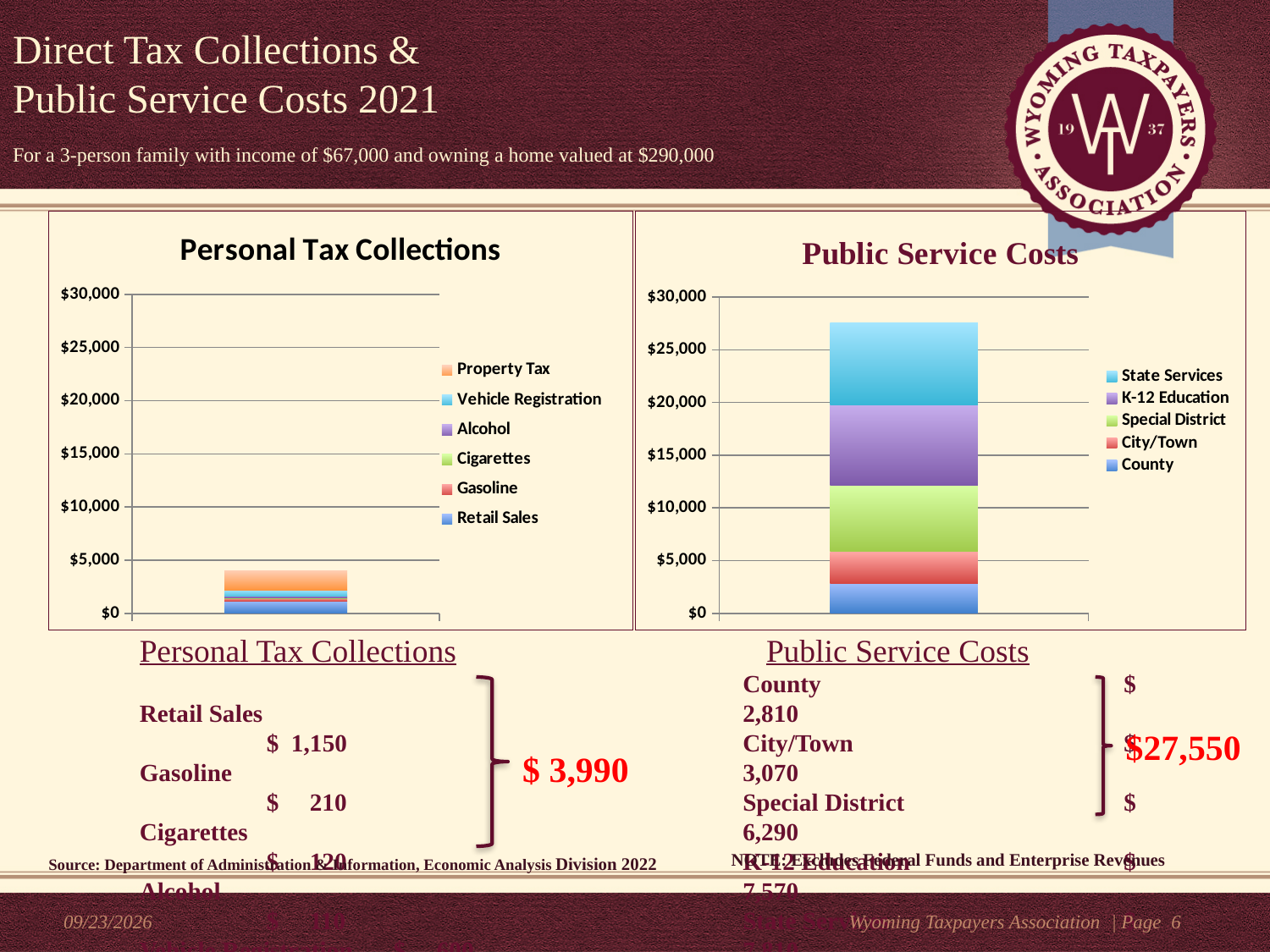
What is the total of the Public Service Costs stacked bar as printed on the slide? $27,550 In the Personal Tax Collections chart, which series has the largest segment in the stacked bar? Property Tax According to the Public Service Costs figures on the slide, what is the value for Special District? $ 6,290 Using the Public Service Costs figures printed on the slide, what is the difference between City/Town and County? $260 In the Personal Tax Collections chart, is the total height of the stacked bar greater or less than $5,000? less What is the total of the Personal Tax Collections stacked bar as printed on the slide? $ 3,990 In the Public Service Costs chart, is the total height of the stacked bar greater or less than $25,000? greater According to the Personal Tax Collections figures on the slide, what is the value for Retail Sales? $ 1,150 How many series does the legend of the Personal Tax Collections chart list? 6 How many series does the legend of the Public Service Costs chart list? 5 In the Public Service Costs chart, which segment is larger, Special District or County? Special District What kind of chart is the Personal Tax Collections chart? bar chart